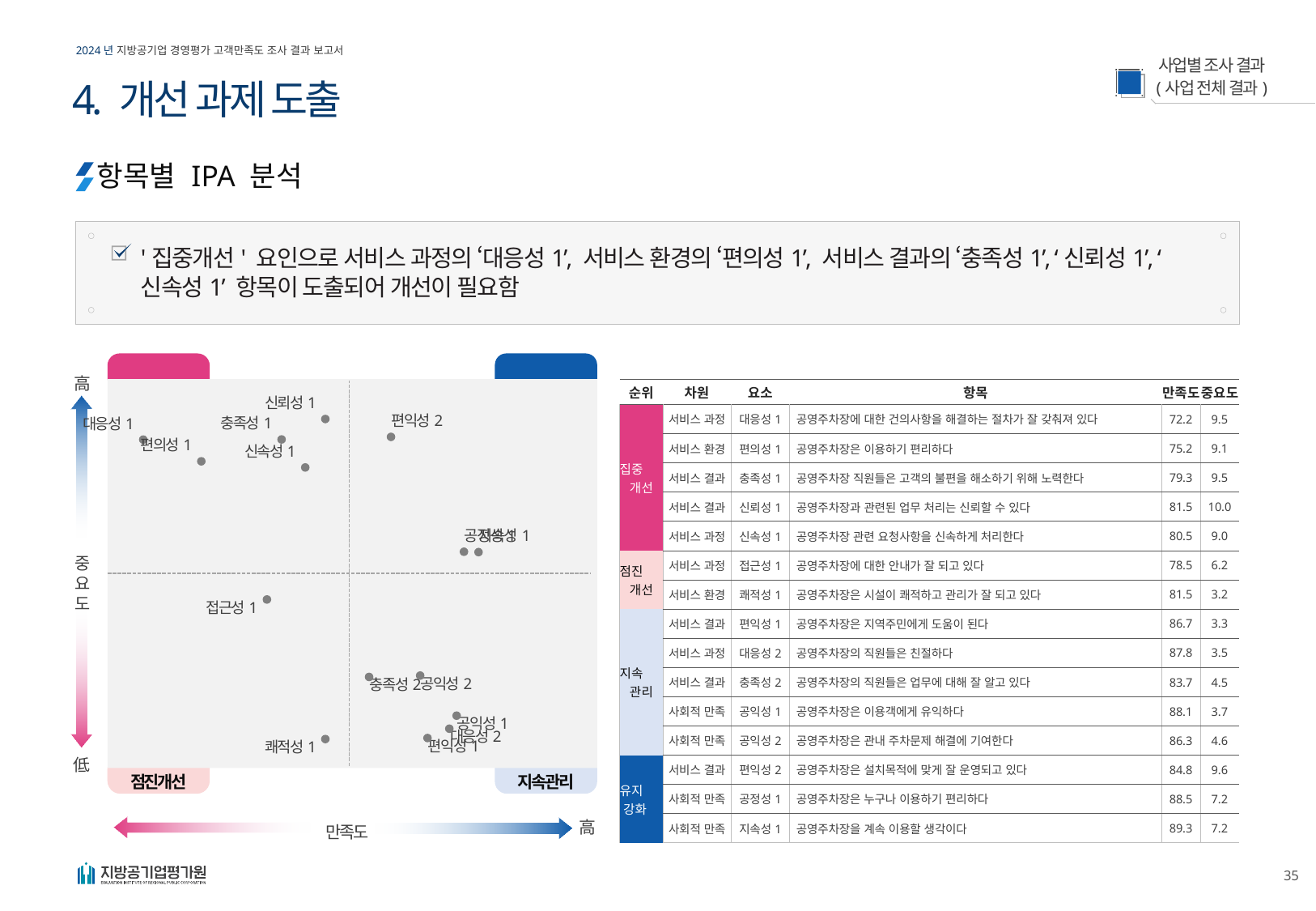
In the IPA chart, which quadrant label appears in the bottom-right corner? 지속관리 In the IPA chart, how many points are plotted in the bottom-left (점진개선) quadrant? 2 In the IPA chart, which point has higher satisfaction (만족도): 편익성 2 or 대응성 1? 편익성 2 In the IPA chart, which quadrant label appears in the bottom-left corner? 점진개선 What is the label of the horizontal axis of the IPA chart? 만족도 In the IPA chart, which point is plotted lowest on the importance (중요도) axis? 쾌적성 1 What kind of chart is shown on the left of the slide? scatter chart In the IPA chart, is 접근성 1 plotted above or below the horizontal midline of importance? below In the IPA chart, which point is plotted furthest left on the satisfaction (만족도) axis? 대응성 1 In the IPA chart, which quadrant contains the point 편익성 2? top-right What is the label of the vertical axis of the IPA chart? 중요도 In the IPA chart, which point has higher importance (중요도): 신뢰성 1 or 쾌적성 1? 신뢰성 1